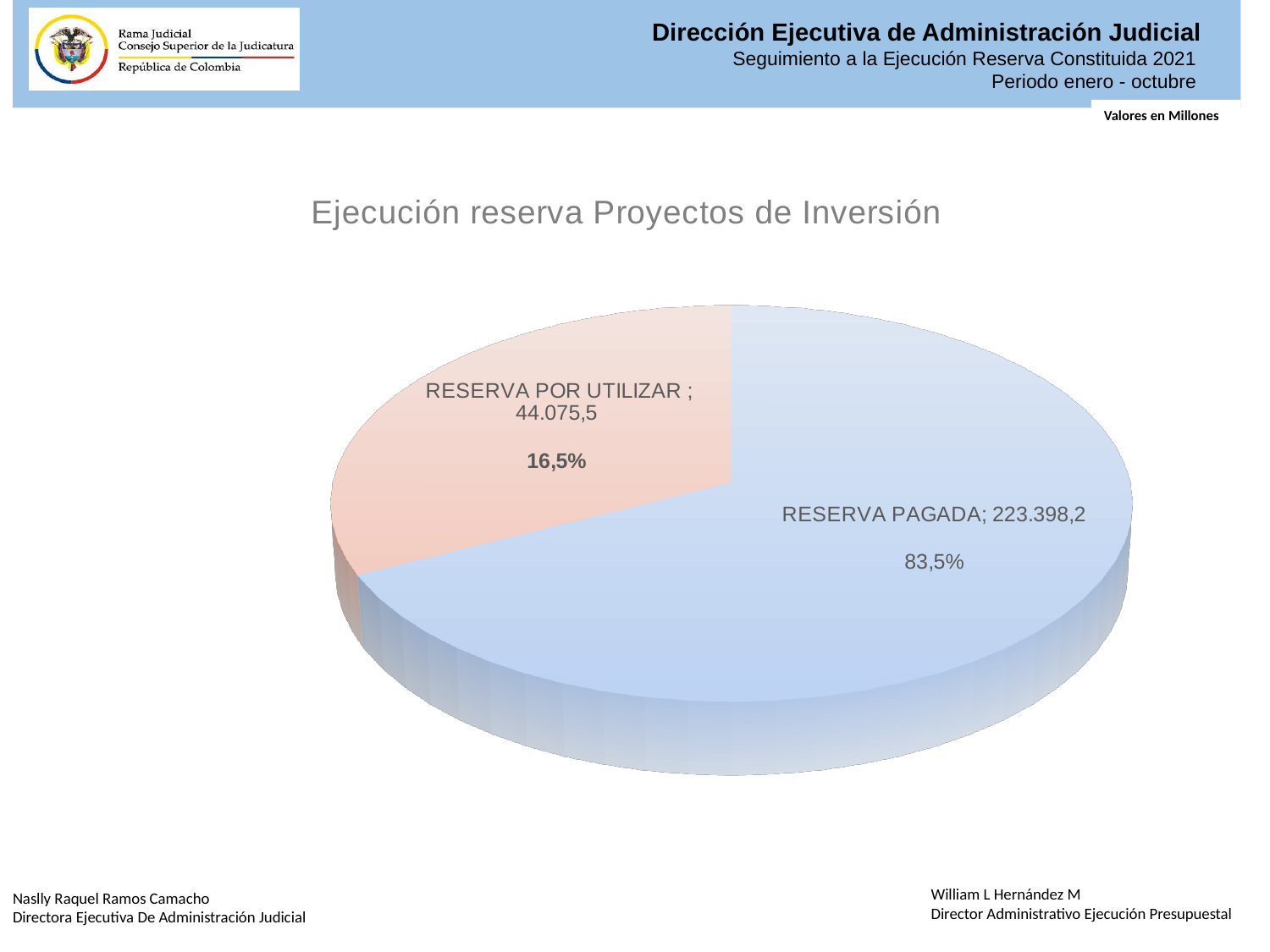
How many slices does the pie chart have? 2 What is the title of the chart? Ejecución reserva Proyectos de Inversión What share of the pie does RESERVA POR UTILIZAR represent? 16,5% What is the value for RESERVA PAGADA? 223.398,2 Which is larger, RESERVA PAGADA or RESERVA POR UTILIZAR? RESERVA PAGADA Which slice is the smallest in the pie chart? RESERVA POR UTILIZAR Which slice is the largest in the pie chart? RESERVA PAGADA What is the difference between the values for RESERVA PAGADA and RESERVA POR UTILIZAR? 179.322,7 In what units are the values on the slide expressed? Millones What type of chart is shown on the slide? Pie chart What is the value for RESERVA POR UTILIZAR? 44.075,5 What share of the pie does RESERVA PAGADA represent? 83,5%